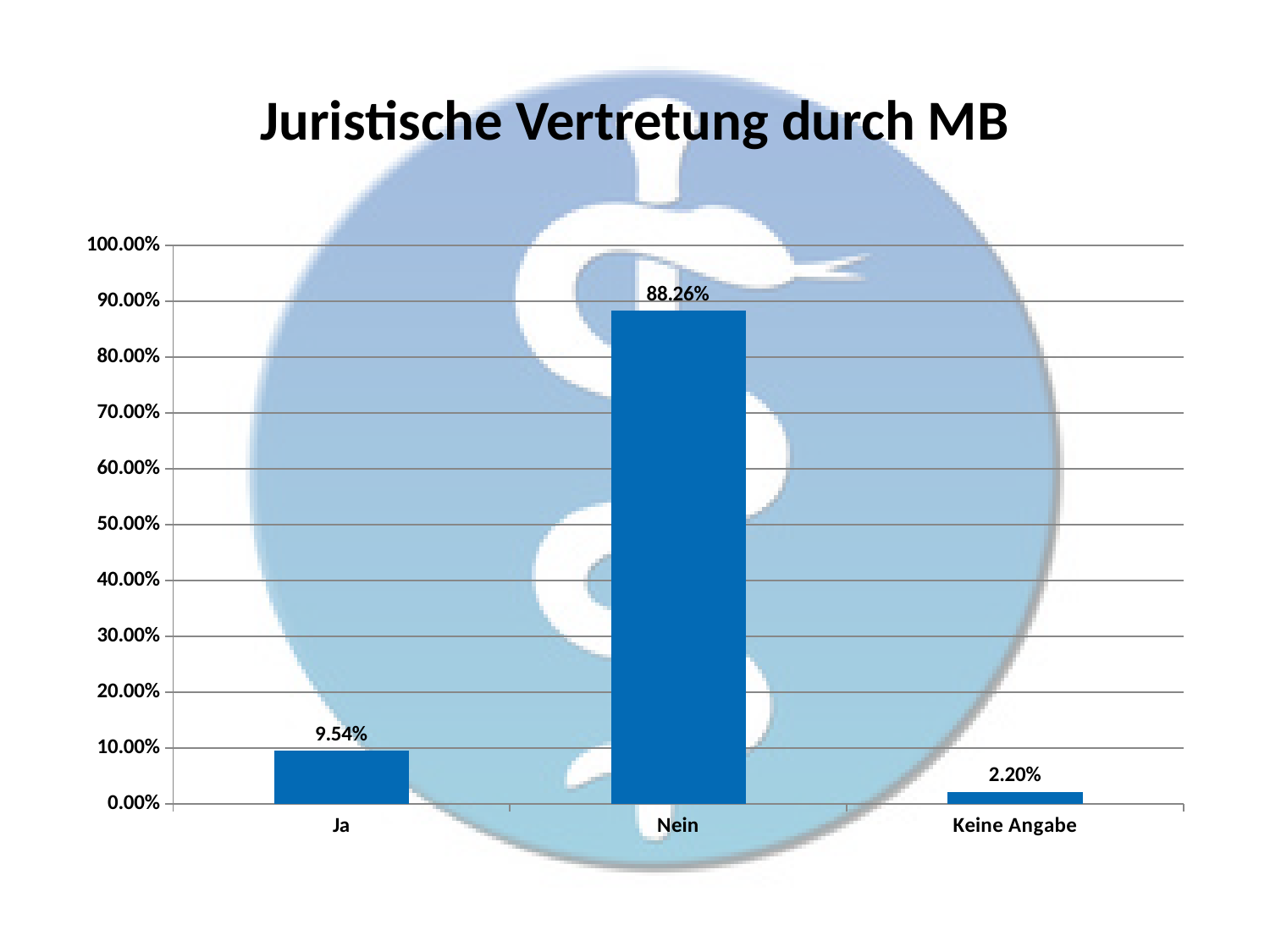
What kind of chart is shown on the slide? Bar chart How many categories are shown on the x axis? 3 Which is larger, the value for Ja or the value for Keine Angabe? Ja Which category has the highest value? Nein What is the value for Nein? 88.26% Which category has the lowest value? Keine Angabe Is the value for Nein greater or less than 80.00%? greater What is the title of the chart? Juristische Vertretung durch MB What is the difference between the values for Ja and Keine Angabe? 7.34% What is the value for Keine Angabe? 2.20% What is the value for Ja? 9.54% What is the difference between the values for Nein and Ja? 78.72%